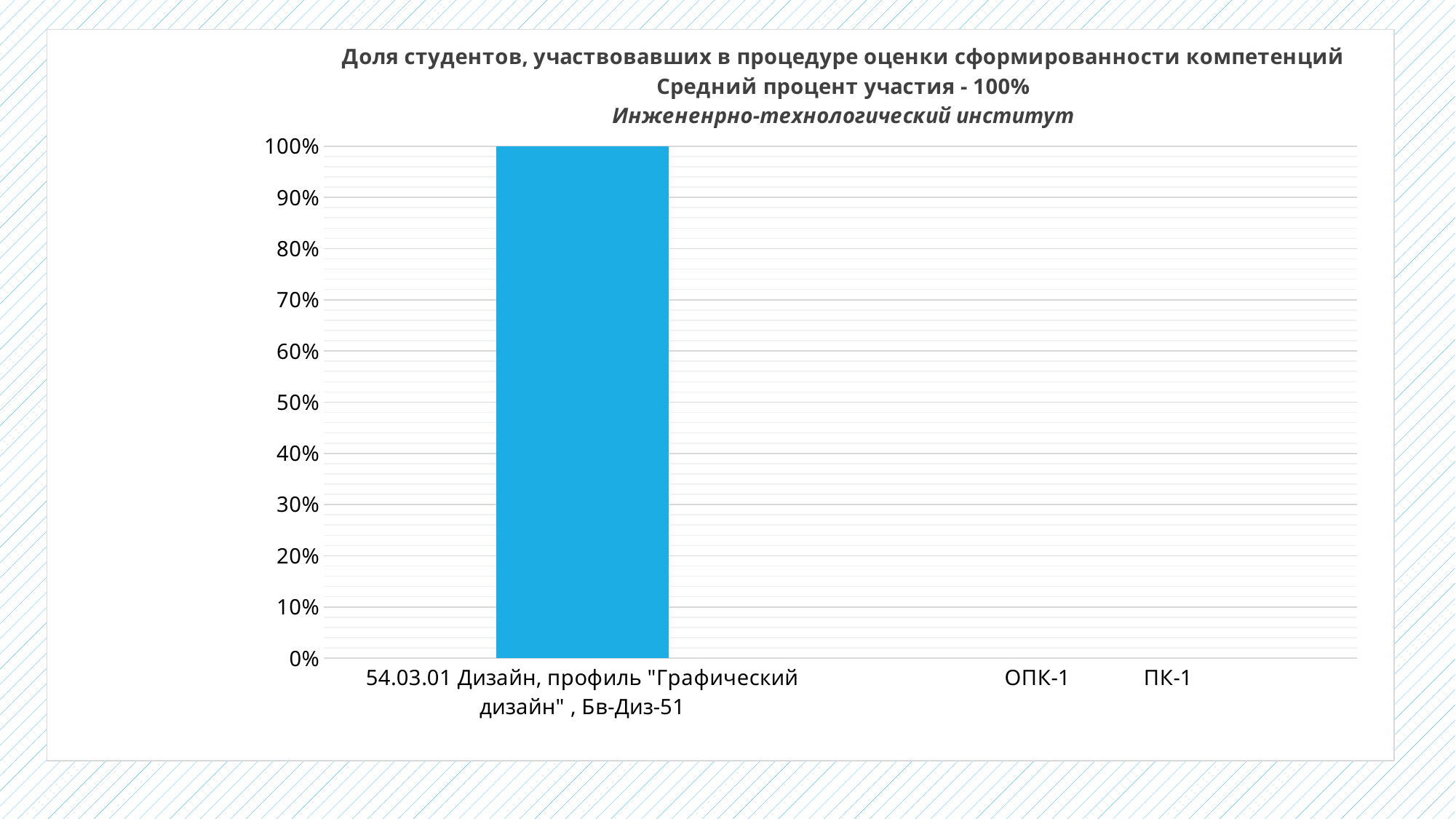
What is the value for 54.03.01 Дизайн, профиль "Графический дизайн", Бв-Диз-51? 100% Is the value for 54.03.01 Дизайн, профиль "Графический дизайн", Бв-Диз-51 greater or less than 50%? greater What kind of chart is shown on the slide? bar chart Which category has the highest bar? 54.03.01 Дизайн, профиль "Графический дизайн", Бв-Диз-51 Is the value for 54.03.01 Дизайн, профиль "Графический дизайн", Бв-Диз-51 greater or less than 90%? greater What is the highest value shown on the y axis? 100% What average participation percentage is stated in the chart title? 100%